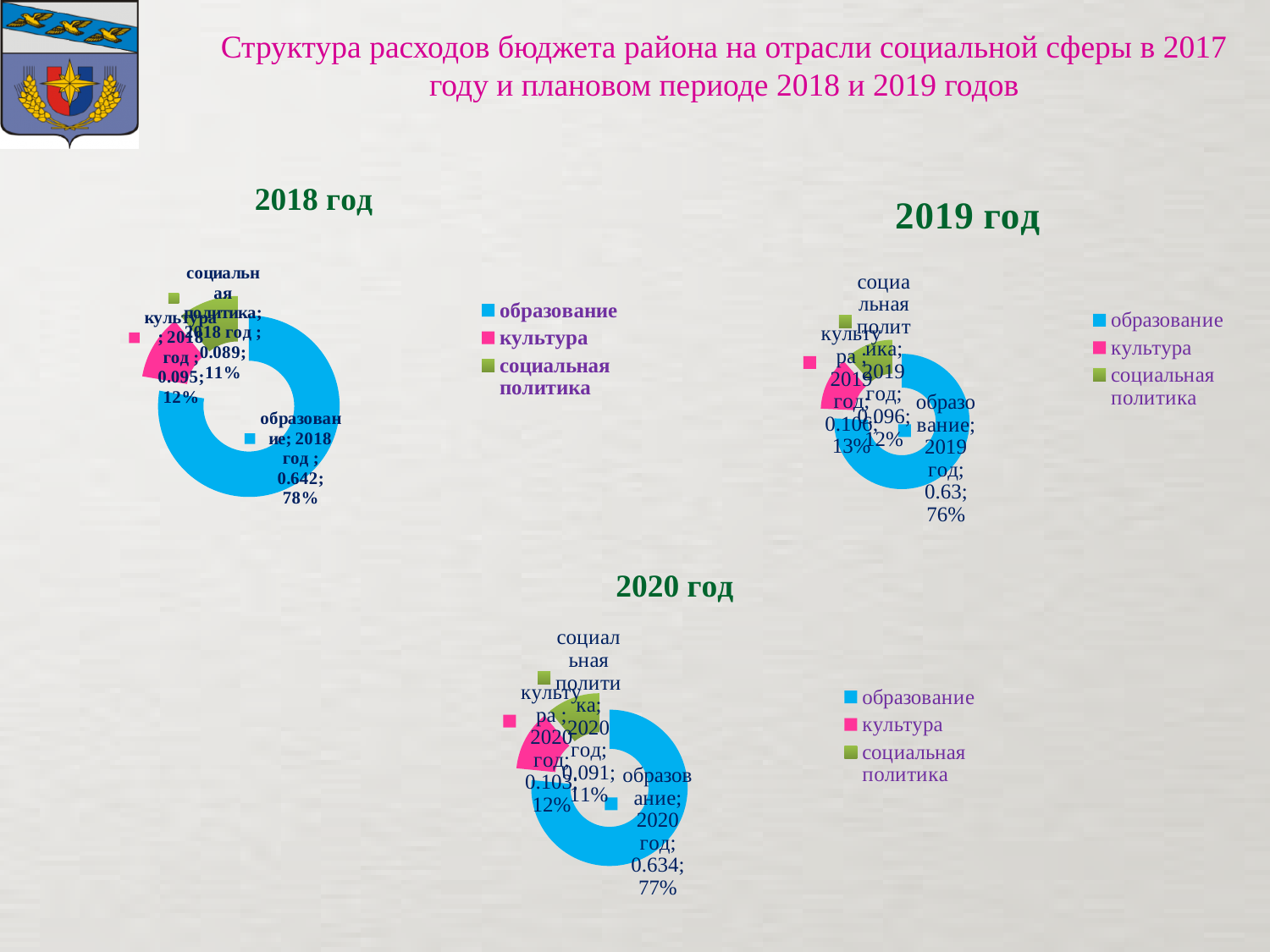
In the 2018 год chart, what value is shown for культура? 0.095 In the 2020 год chart, what value is shown for образование? 0.634 In the 2020 год chart, which is larger, культура or социальная политика? культура In the 2018 год chart, which category has the smallest share? социальная политика In the 2020 год chart, which category has the largest share? образование In the 2019 год chart, what share does социальная политика have? 12% In the 2020 год chart, what share does культура have? 12% In the 2019 год chart, what value is shown for культура? 0.106 What kind of chart is the 2018 год chart? doughnut chart How many series does the legend of the 2019 год chart list? 3 In the 2018 год chart, what share does образование have? 78%